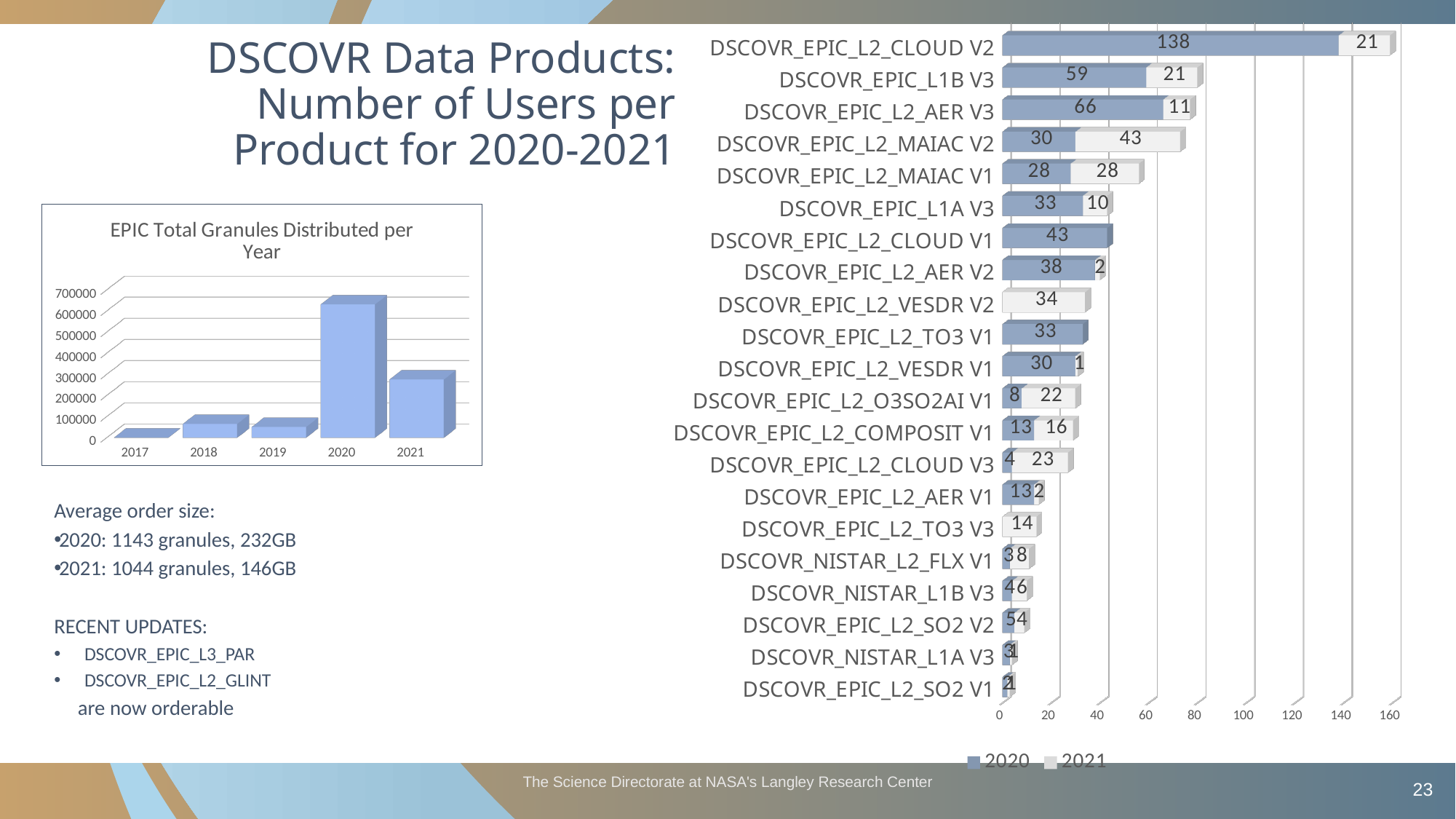
How many series does the legend of the chart on the right list? 2 In the 'EPIC Total Granules Distributed per Year' chart, is the value for 2020 greater or less than 500000? greater In the 'EPIC Total Granules Distributed per Year' chart, is the value for 2021 greater or less than 400000? less In the chart on the right, what is the total number of users for DSCOVR_EPIC_L2_CLOUD V2 across 2020 and 2021? 159 What kind of chart is the 'EPIC Total Granules Distributed per Year' chart? Bar chart In the chart on the right, how many users did DSCOVR_EPIC_L2_CLOUD V2 have in 2020? 138 In the chart on the right, how many users did DSCOVR_EPIC_L2_MAIAC V2 have in 2021? 43 In the 'EPIC Total Granules Distributed per Year' chart, which year has the highest value? 2020 In the chart on the right, what is the difference between the 2020 and 2021 user counts for DSCOVR_EPIC_L1B V3? 38 In the chart on the right, which product has the highest number of users in 2020? DSCOVR_EPIC_L2_CLOUD V2 How many products are listed in the chart on the right? 21 In the chart on the right, which had more users in 2021: DSCOVR_EPIC_L2_O3SO2AI V1 or DSCOVR_EPIC_L2_AER V3? DSCOVR_EPIC_L2_O3SO2AI V1